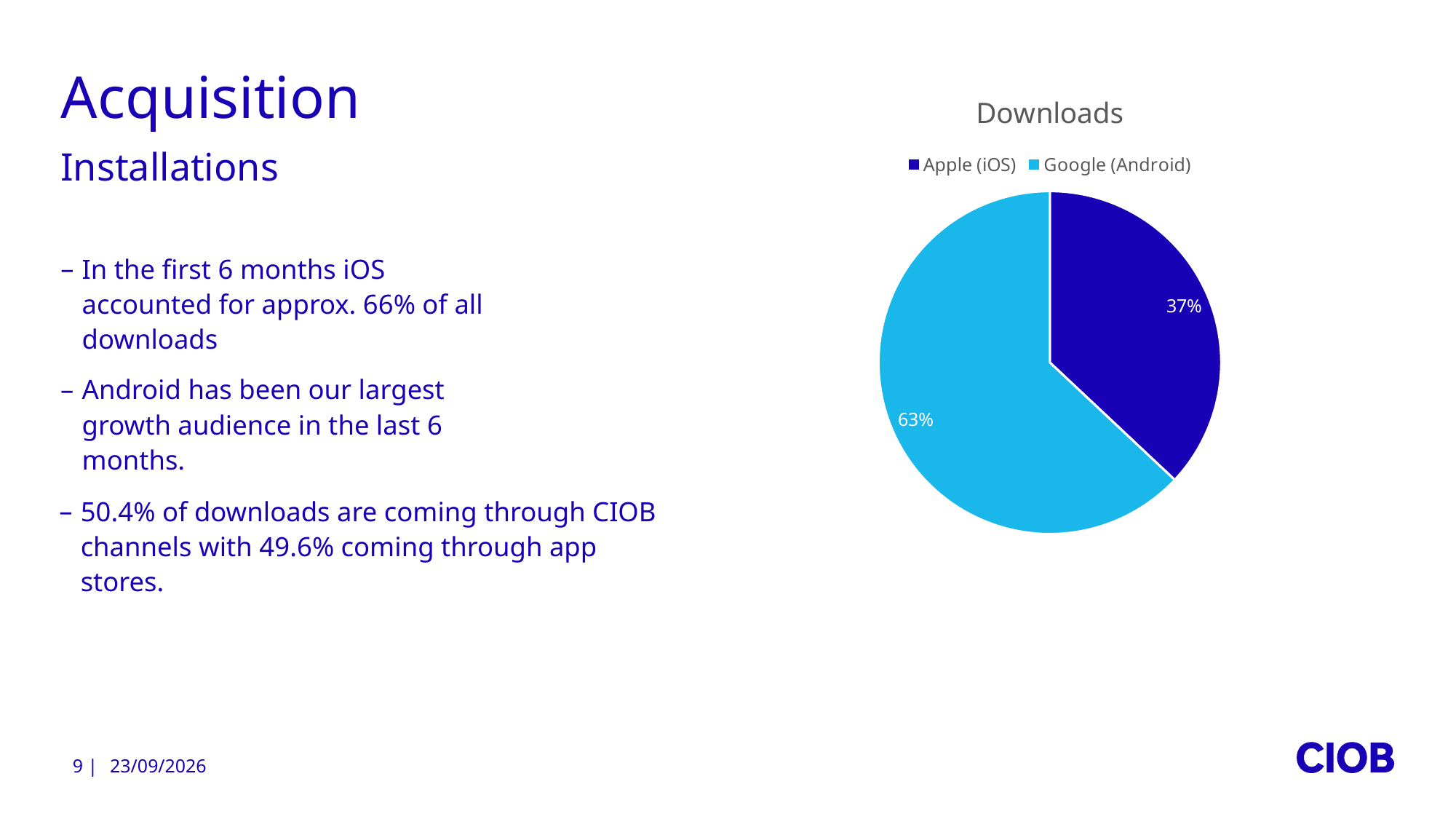
What type of chart is shown on the slide? Pie chart What share of the Downloads pie does the Google (Android) slice represent? 63% Which platform has the smallest slice in the Downloads pie chart? Apple (iOS) Which is larger in the Downloads chart, the Apple (iOS) slice or the Google (Android) slice? Google (Android) How many entries does the legend of the Downloads chart list? 2 Which platform has the largest slice in the Downloads pie chart? Google (Android) What share of downloads does Apple (iOS) account for in the Downloads pie chart? 37% What is the title of the chart on the slide? Downloads What share of downloads does Google (Android) account for in the Downloads pie chart? 63% What is the difference in percentage points between the Google (Android) and Apple (iOS) slices? 26 How many slices does the Downloads pie chart have? 2 Which colour represents Apple (iOS) in the Downloads pie chart? Dark blue